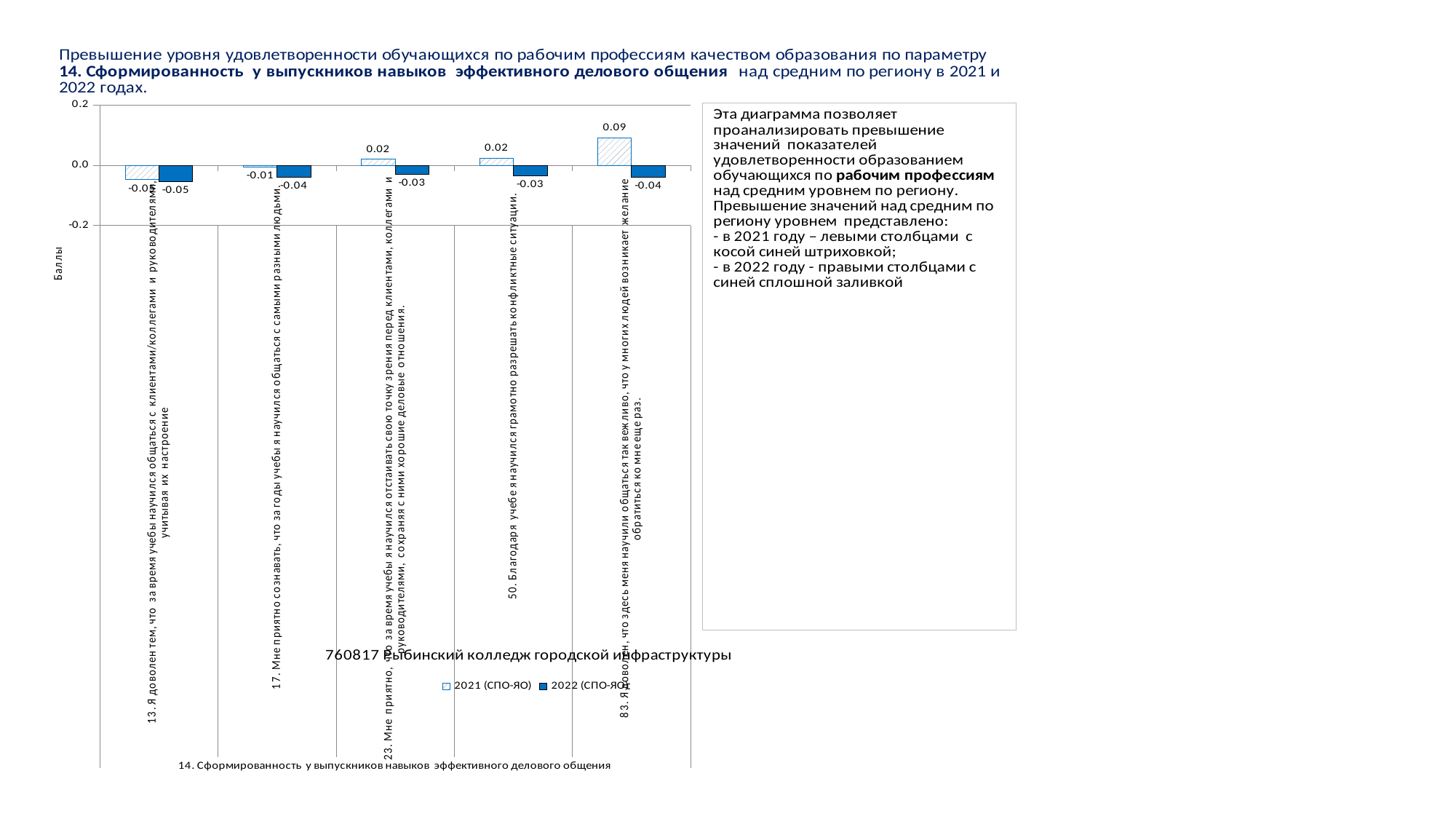
How many categories (statements) are plotted on the x axis of the chart? 5 What is the 2022 (СПО-ЯО) value for statement 13 ("Я доволен тем, что за время учебы научился общаться с клиентами/коллегами и руководителями...")? -0.05 What type of chart is shown on the slide? Bar chart Which statement has the lowest 2022 (СПО-ЯО) value? 13. Я доволен тем, что за время учебы научился общаться с клиентами/коллегами и руководителями, учитывая их настроение What is the 2021 (СПО-ЯО) value for statement 83 ("Я доволен, что здесь меня научили общаться так вежливо...")? 0.09 What is the difference between the 2021 (СПО-ЯО) and 2022 (СПО-ЯО) values for statement 83? 0.13 For statement 23, which series has the larger value: 2021 (СПО-ЯО) or 2022 (СПО-ЯО)? 2021 (СПО-ЯО) What is the 2021 (СПО-ЯО) value for statement 50 ("Благодаря учебе я научился грамотно разрешать конфликтные ситуации")? 0.02 What is the 2022 (СПО-ЯО) value for statement 17 ("Мне приятно сознавать, что за годы учебы я научился общаться с самыми разными людьми")? -0.04 Which statement has the highest 2021 (СПО-ЯО) value? 83. Я доволен, что здесь меня научили общаться так вежливо, что у многих людей возникает желание обратиться ко мне еще раз How many series does the chart legend list? 2 What is the title of the vertical axis of the chart? Баллы